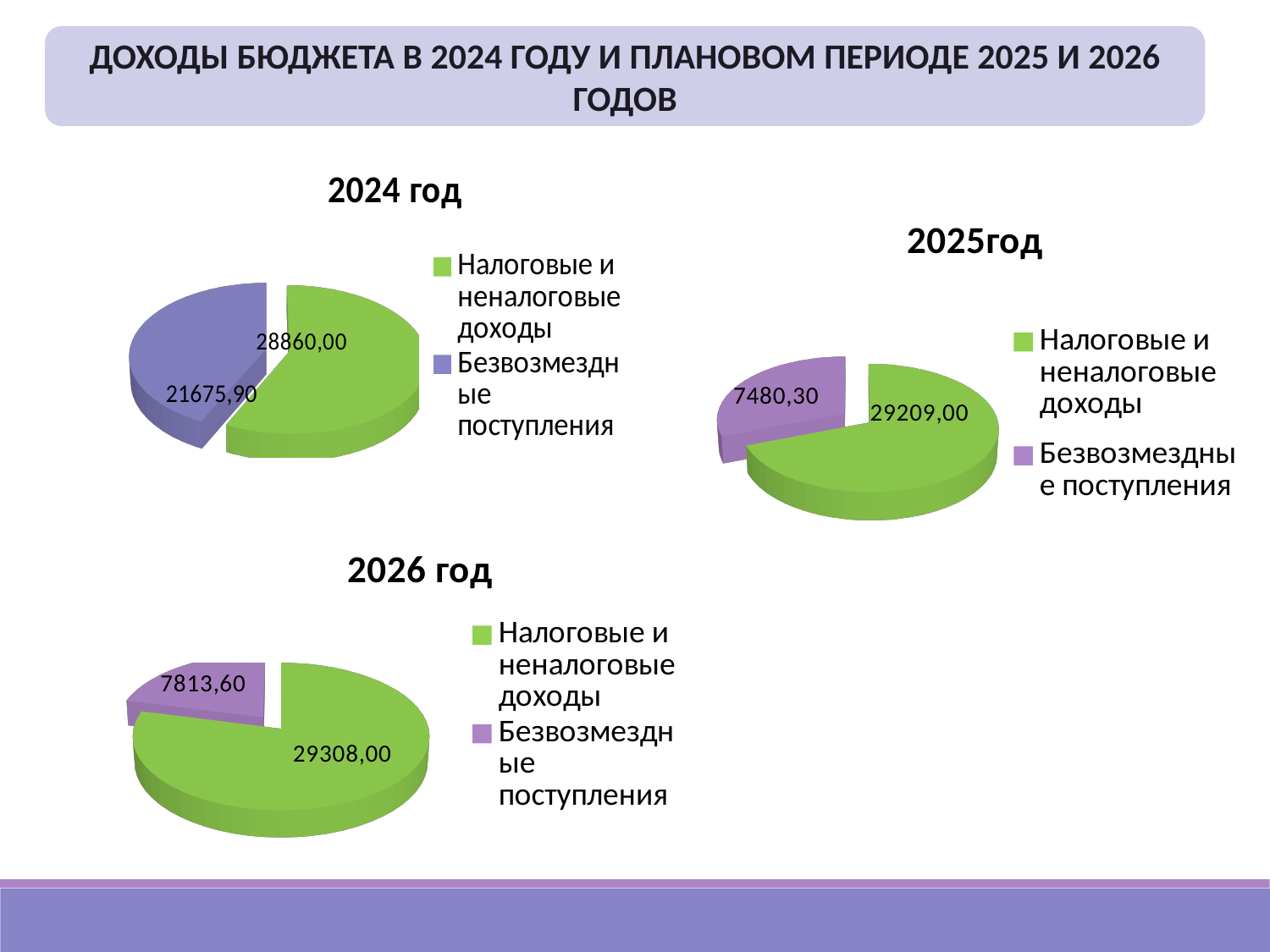
What type of chart is used for 2024 год? Pie chart On the 2025год chart, what is the value for Безвозмездные поступления? 7480,30 On the 2025год chart, what is the total of the two slices? 36689,30 On the 2025год chart, which category has the largest slice? Налоговые и неналоговые доходы On the 2024 год chart, what is the difference between Налоговые и неналоговые доходы and Безвозмездные поступления? 7184,10 On the 2026 год chart, what is the value for Налоговые и неналоговые доходы? 29308,00 On the 2024 год chart, what is the value for Безвозмездные поступления? 21675,90 On the 2026 год chart, which category has the smallest slice? Безвозмездные поступления On the 2026 год chart, what is the difference between Налоговые и неналоговые доходы and Безвозмездные поступления? 21494,40 On the 2024 год chart, what is the value for Налоговые и неналоговые доходы? 28860,00 How many charts are shown on the slide? 3 Which is larger: Безвозмездные поступления on the 2024 год chart or on the 2026 год chart? 2024 год